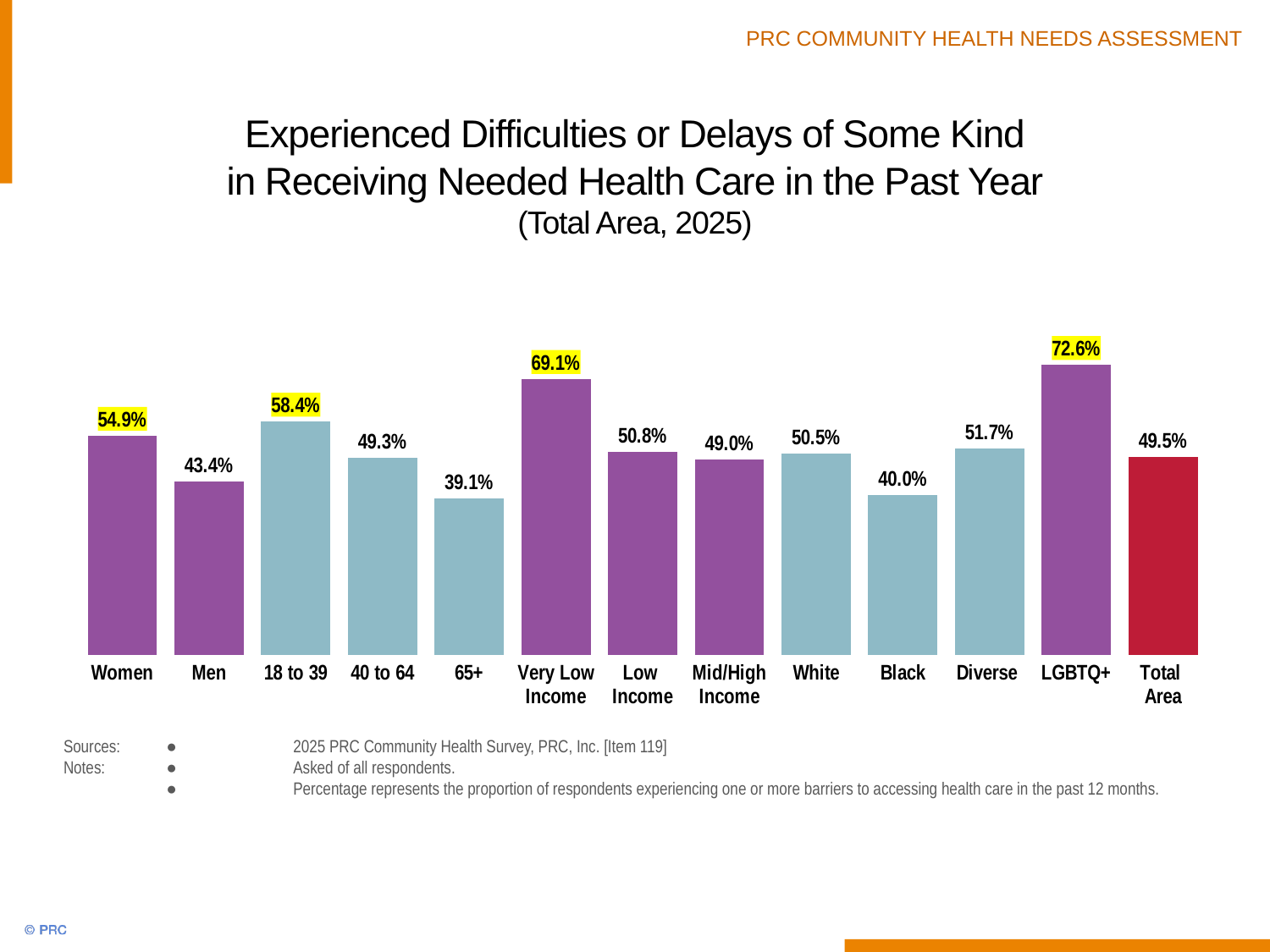
Which category has the highest value on the chart? LGBTQ+ Which is larger, the value for Low Income or the value for Mid/High Income? Low Income Which category has the lowest value on the chart? 65+ What is the difference between the values for 18 to 39 and 65+? 19.3% What is the difference between the values for Women and Men? 11.5% What percentage of women experienced difficulties or delays in receiving needed health care? 54.9% Which is larger, the value for White or the value for Black? White Which year is given in the chart's subtitle? 2025 What kind of chart is shown on the slide? Bar chart How many categories are shown on the chart? 13 What is the value for the Total Area bar? 49.5% What is the value shown for the Very Low Income group? 69.1%